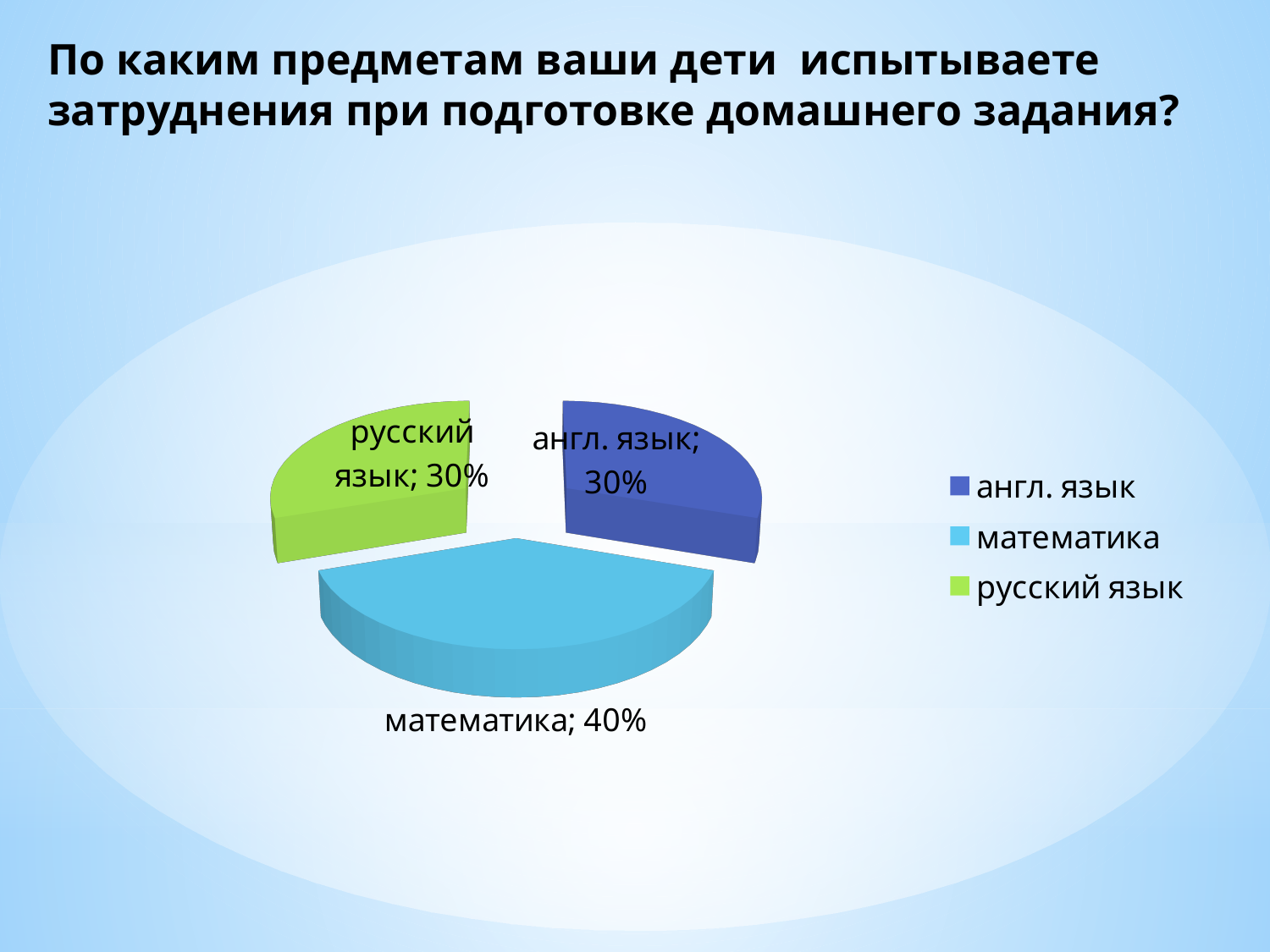
How many entries does the legend list? 3 Which category is shown in green in the legend? русский язык What is the value shown for англ. язык? 30% What share of the pie does математика have? 40% Which category has the largest slice of the pie? математика What kind of chart is shown on the slide? pie chart What is the value shown for русский язык? 30% What is the difference between the value for математика and the value for англ. язык? 10% Which is larger, the value for математика or the value for русский язык? математика Which colour is used for the математика slice? light blue How many slices does the pie chart have? 3